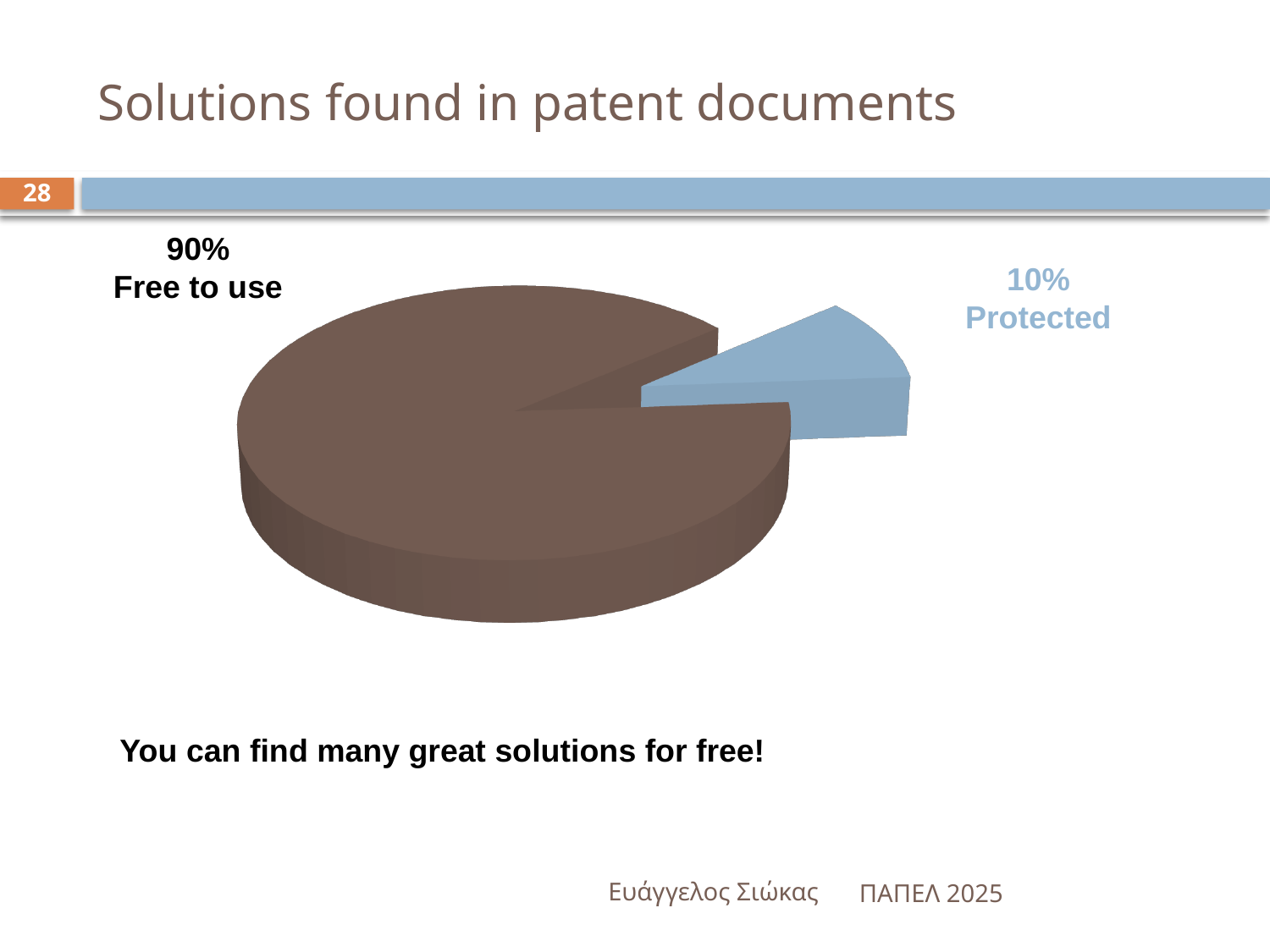
How many slices does the pie chart have? 2 Which is larger, the "Free to use" slice or the "Protected" slice? Free to use What share of the pie is labelled "Free to use"? 90% Which slice of the pie is the largest? Free to use What kind of chart is shown on the slide? pie chart What colour is the "Free to use" slice of the pie? brown What colour is the "Protected" slice of the pie? light blue What is the difference in percentage points between the "Free to use" and "Protected" slices? 80 What share of the pie is labelled "Protected"? 10% Which slice of the pie is the smallest? Protected